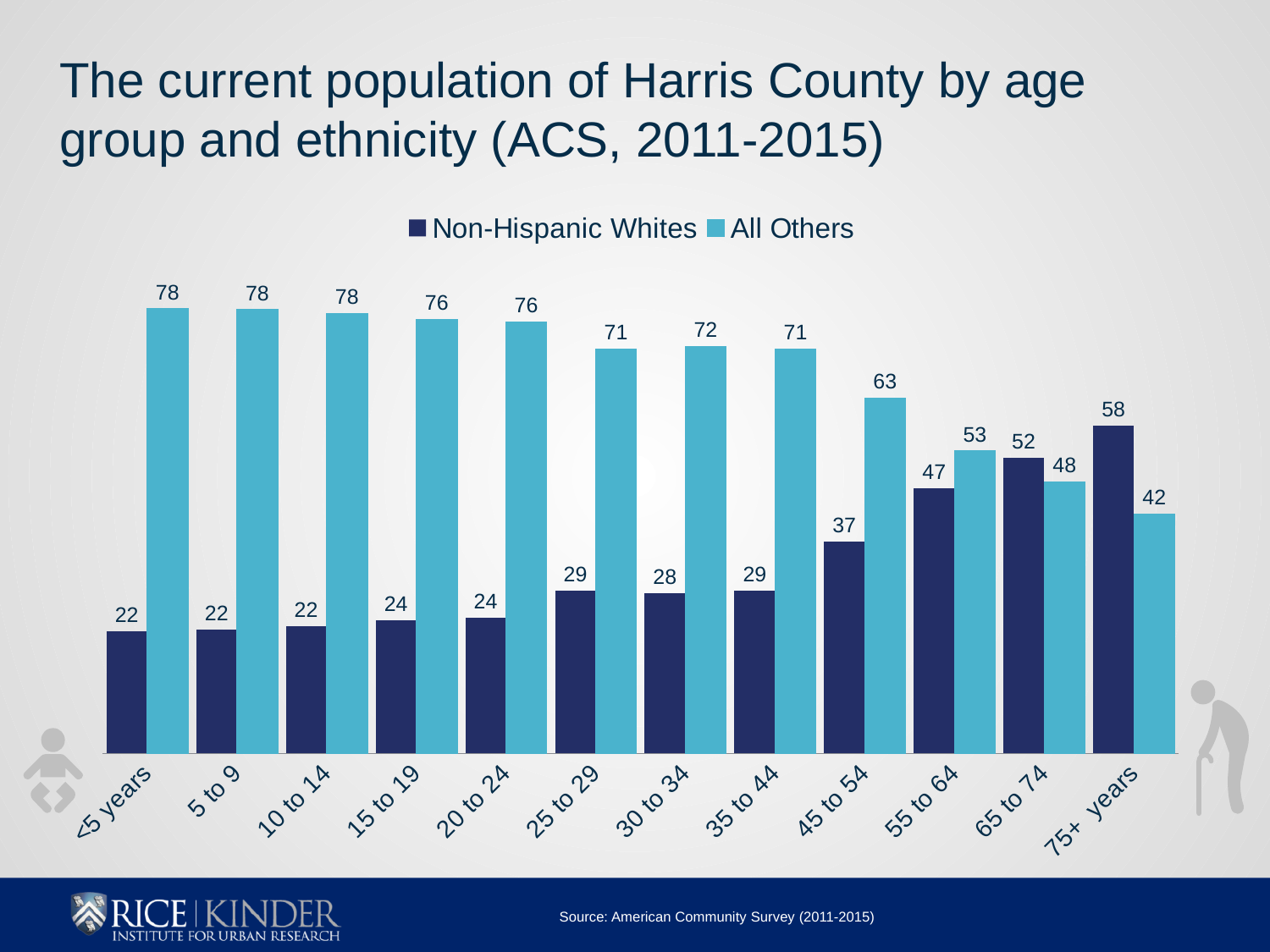
What is the value for Non-Hispanic Whites in the 75+ years age group? 58 What is the difference between All Others and Non-Hispanic Whites in the 55 to 64 age group? 6 Which is larger in the 65 to 74 age group: Non-Hispanic Whites or All Others? Non-Hispanic Whites How many series does the legend list? 2 What kind of chart is shown on the slide? Bar chart Do the values for Non-Hispanic Whites generally rise or fall from the youngest to the oldest age group? Rise What is the value for All Others in the 25 to 29 age group? 71 What is the value for Non-Hispanic Whites in the 45 to 54 age group? 37 What colour are the bars for All Others? Light blue How many age groups are shown on the x axis? 12 Which age group has the highest value for Non-Hispanic Whites? 75+ years Which age group has the lowest value for All Others? 75+ years